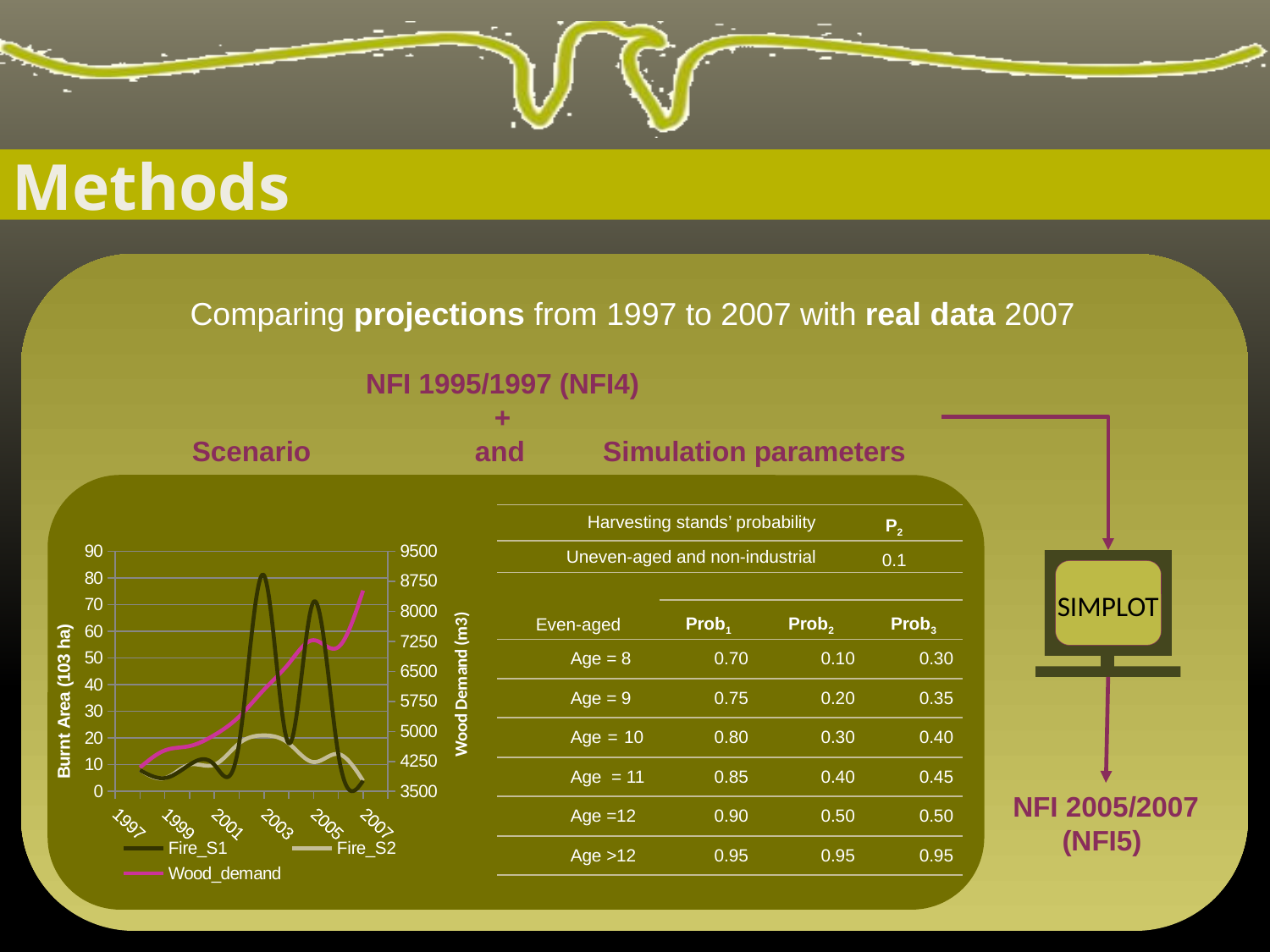
How many year labels are shown on the x axis of the line chart? 6 Is the Wood_demand value in 1997 greater or less than 5000 on the Wood Demand axis? less Does the Wood_demand series generally rise or fall from 1997 to 2007? rise Is the highest value of the Fire_S2 series greater or less than 30 on the Burnt Area axis? less Is the Wood_demand value in 2007 greater or less than 8000 on the Wood Demand axis? greater What are the three series named in the legend of the line chart? Fire_S1, Fire_S2, Wood_demand In 2003, which series has the higher burnt area, Fire_S1 or Fire_S2? Fire_S1 What kind of chart is shown on the left of the slide? line chart In which year does the Fire_S1 series reach its highest burnt area? 2003 What is the title of the left vertical axis of the line chart? Burnt Area (103 ha) How many series does the legend of the line chart list? 3